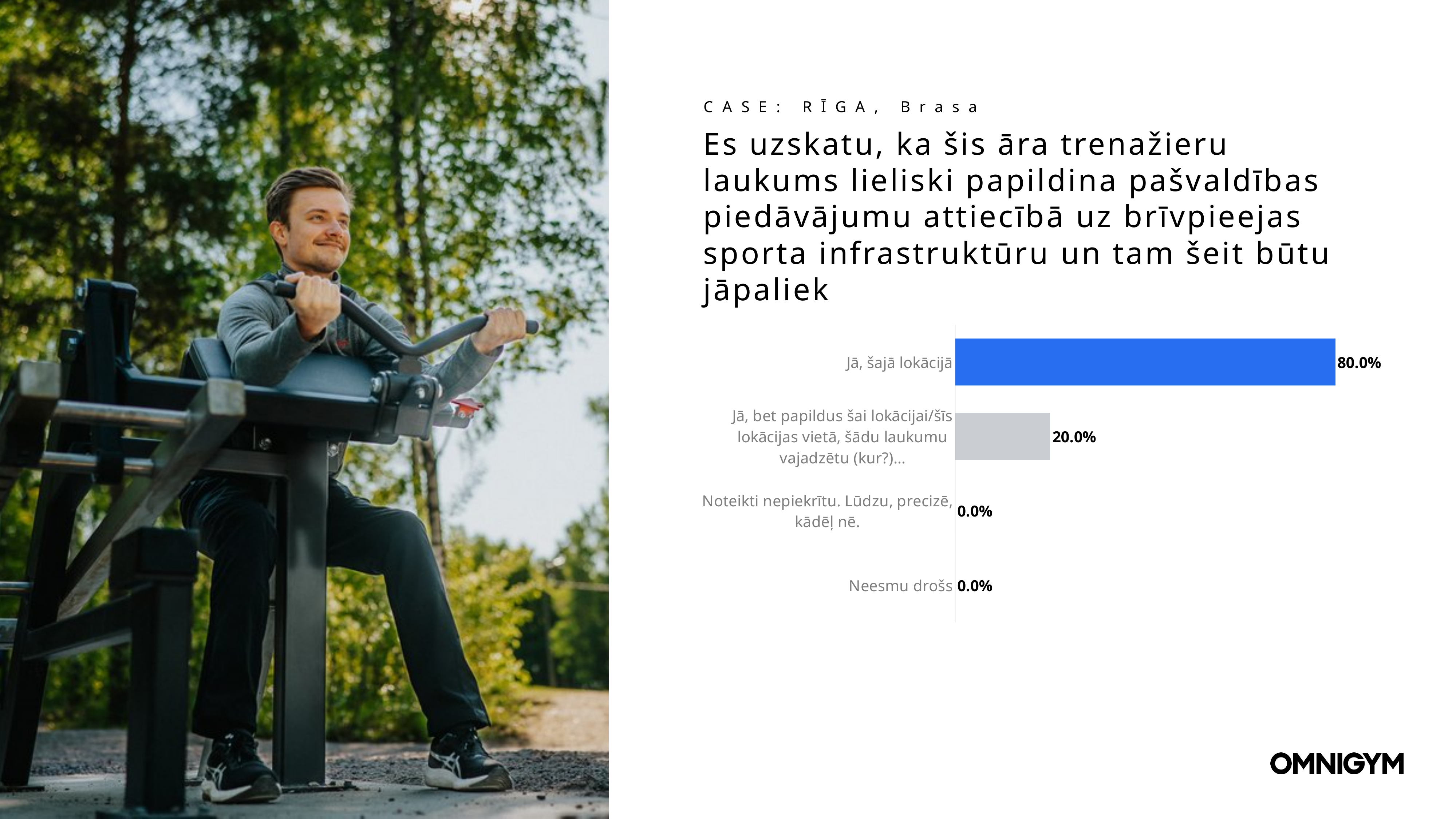
Which is larger: the value for "Jā, šajā lokācijā" or the value for "Jā, bet papildus šai lokācijai/šīs lokācijas vietā, šādu laukumu vajadzētu (kur?)..."? Jā, šajā lokācijā What is the difference between the values for "Jā, šajā lokācijā" and "Jā, bet papildus šai lokācijai/šīs lokācijas vietā, šādu laukumu vajadzētu (kur?)..."? 60.0% What is the value for "Noteikti nepiekrītu. Lūdzu, precizē, kādēļ nē."? 0.0% Which category has the highest value? Jā, šajā lokācijā What is the total of the values for "Jā, šajā lokācijā" and "Jā, bet papildus šai lokācijai/šīs lokācijas vietā, šādu laukumu vajadzētu (kur?)..."? 100.0% What is the value for "Jā, bet papildus šai lokācijai/šīs lokācijas vietā, šādu laukumu vajadzētu (kur?)..."? 20.0% How many categories does the chart show? 4 How many categories have a value of 0.0%? 2 What is the value for "Neesmu drošs"? 0.0% What kind of chart is shown on the slide? Bar chart What colour is the bar for "Jā, šajā lokācijā"? Blue What is the value for "Jā, šajā lokācijā"? 80.0%